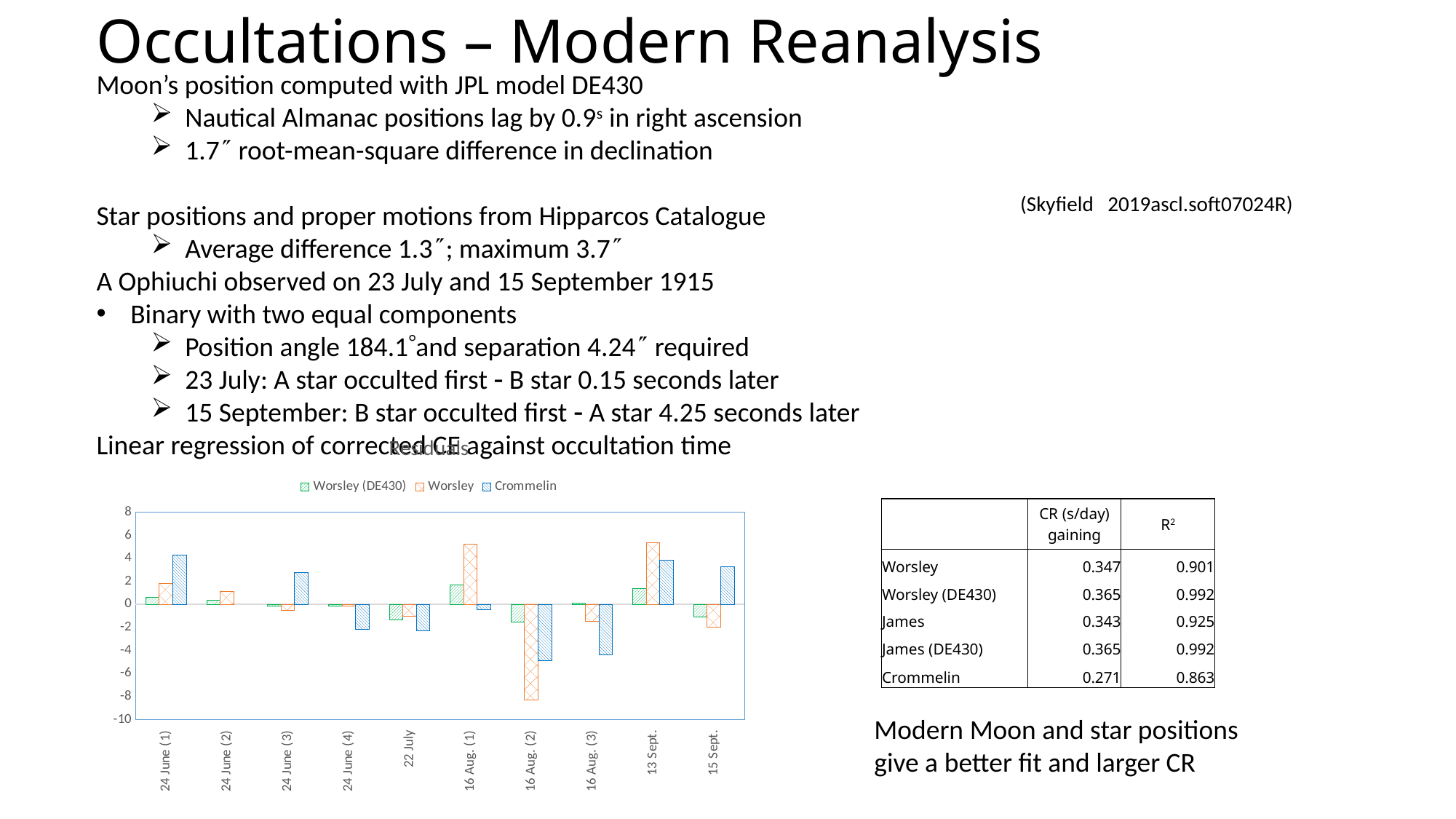
Is the Crommelin value for 16 Aug. (3) greater or less than -2? less For 16 Aug. (1), which is larger: the Worsley (DE430) value or the Worsley value? Worsley How many series does the chart's legend list? 3 For 24 June (1), which is larger: the Worsley value or the Crommelin value? Crommelin Which category has the lowest value in the chart? 16 Aug. (2) Is the Crommelin value for 15 Sept. greater or less than 2? greater What kind of chart is shown on the slide? bar chart Is the Crommelin value for 24 June (1) greater or less than 2? greater Which series are listed in the chart's legend? Worsley (DE430), Worsley, Crommelin How many categories are shown along the x axis of the chart? 10